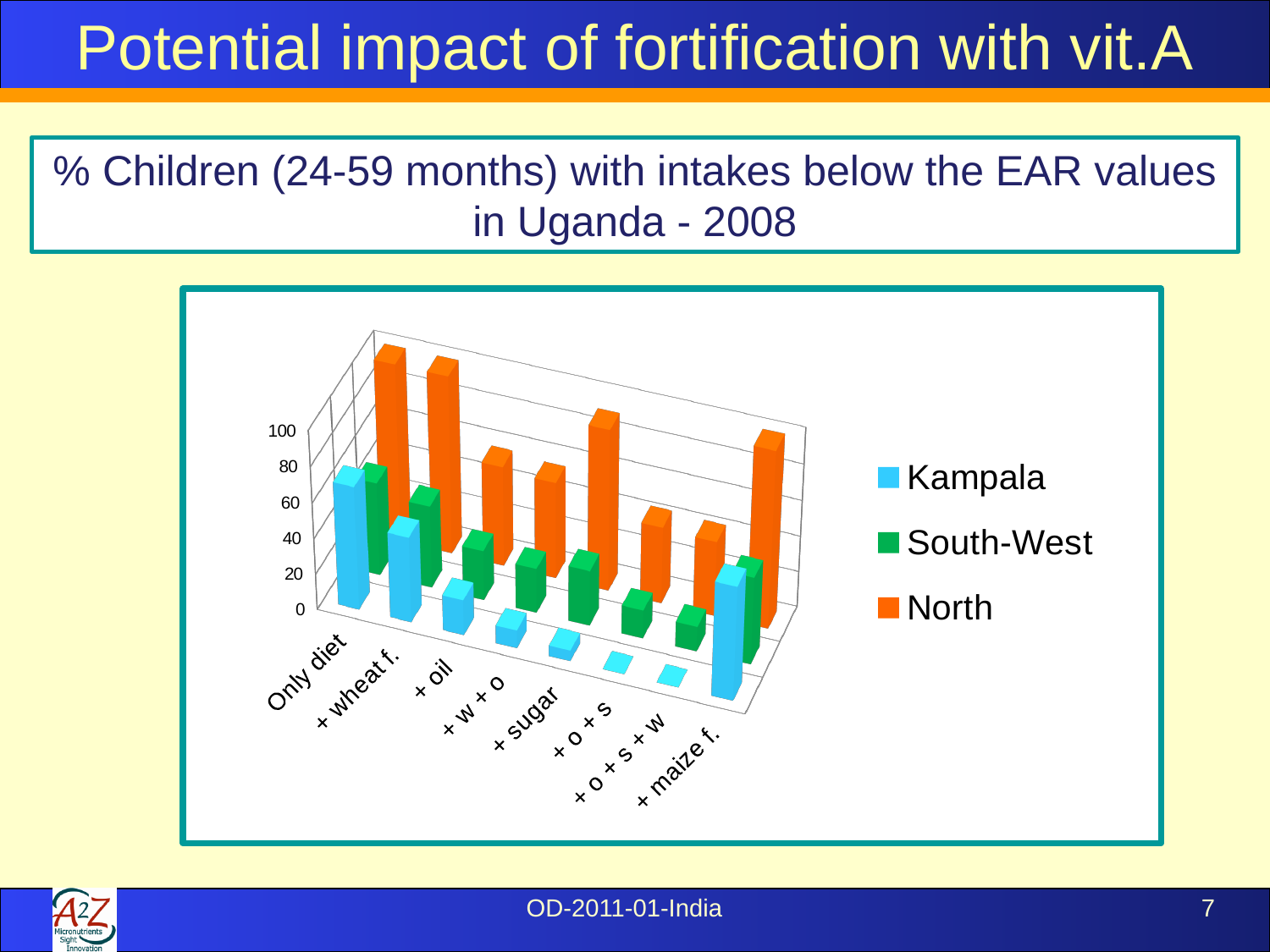
What kind of chart is shown on the slide? bar chart Which series is shown in light blue in the legend? Kampala How many categories are shown along the x axis? 8 Is the value for Kampala at 'Only diet' greater or less than 40? greater Which series is shown in orange in the legend? North For Kampala, which is larger: the value at 'Only diet' or at '+ wheat f.'? Only diet Which series has the highest value at 'Only diet'? North Is the value for South-West at '+ o + s + w' greater or less than 40? less Is the value for Kampala at '+ o + s' greater or less than 20? less How many series does the legend list? 3 At '+ o + s', which series has the larger value: North or Kampala? North